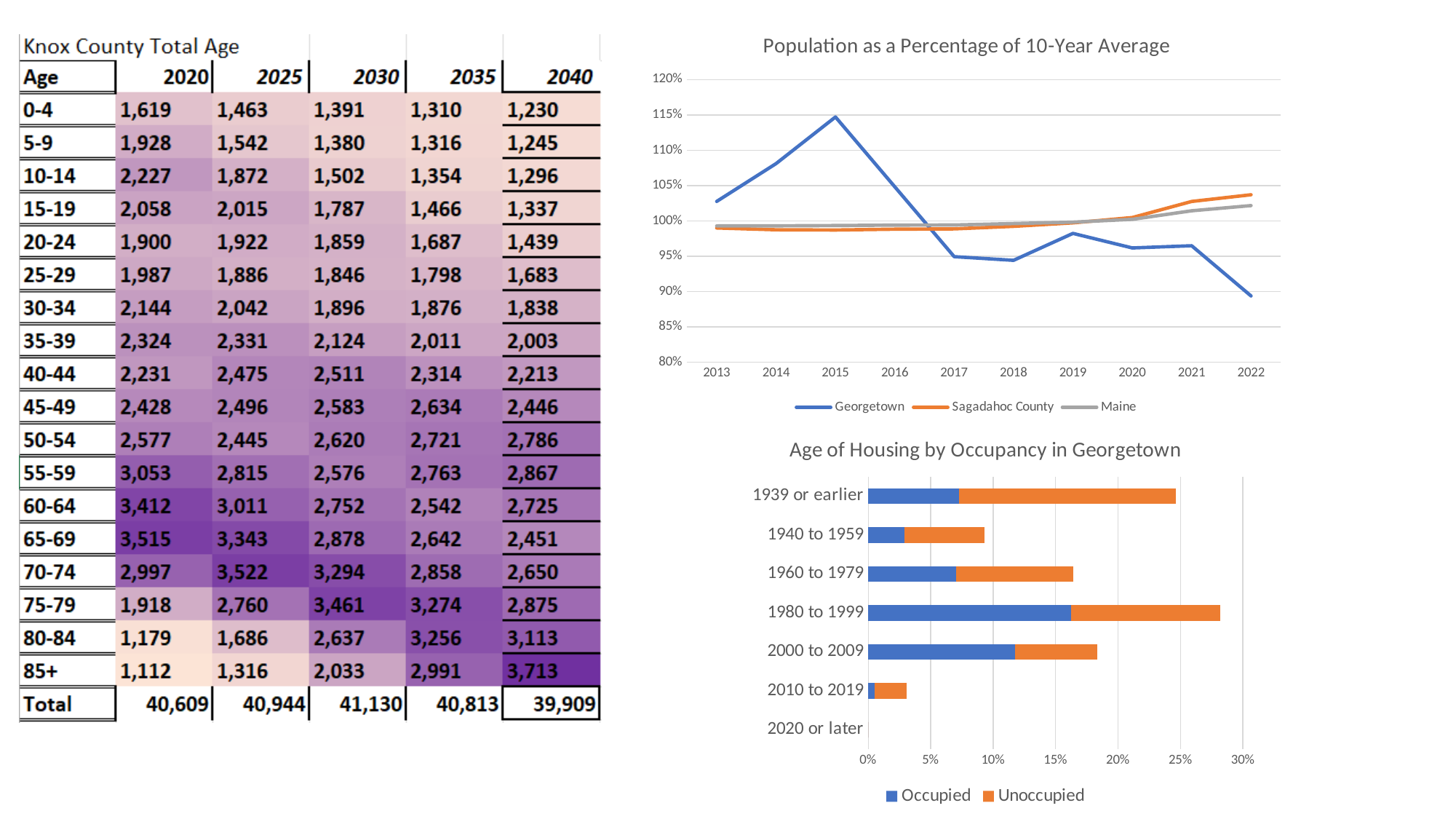
What kind of chart is 'Age of Housing by Occupancy in Georgetown'? bar chart In 'Population as a Percentage of 10-Year Average', is the value for Georgetown in 2022 greater or less than 90%? less In 'Population as a Percentage of 10-Year Average', which year has the lowest value for Georgetown? 2022 In 'Age of Housing by Occupancy in Georgetown', which category has the longest total bar? 1980 to 1999 How many series does the legend of 'Age of Housing by Occupancy in Georgetown' list? 2 In 'Population as a Percentage of 10-Year Average', does the Georgetown line rise or fall between 2015 and 2017? fall In 'Population as a Percentage of 10-Year Average', how many years are shown on the x axis? 10 In 'Population as a Percentage of 10-Year Average', which year has the highest value for Georgetown? 2015 What kind of chart is 'Population as a Percentage of 10-Year Average'? line chart In 'Population as a Percentage of 10-Year Average', is the value for Georgetown in 2015 greater or less than 110%? greater How many series does the legend of 'Population as a Percentage of 10-Year Average' list? 3 In 'Age of Housing by Occupancy in Georgetown', is the total bar for 1940 to 1959 greater or less than 10%? less